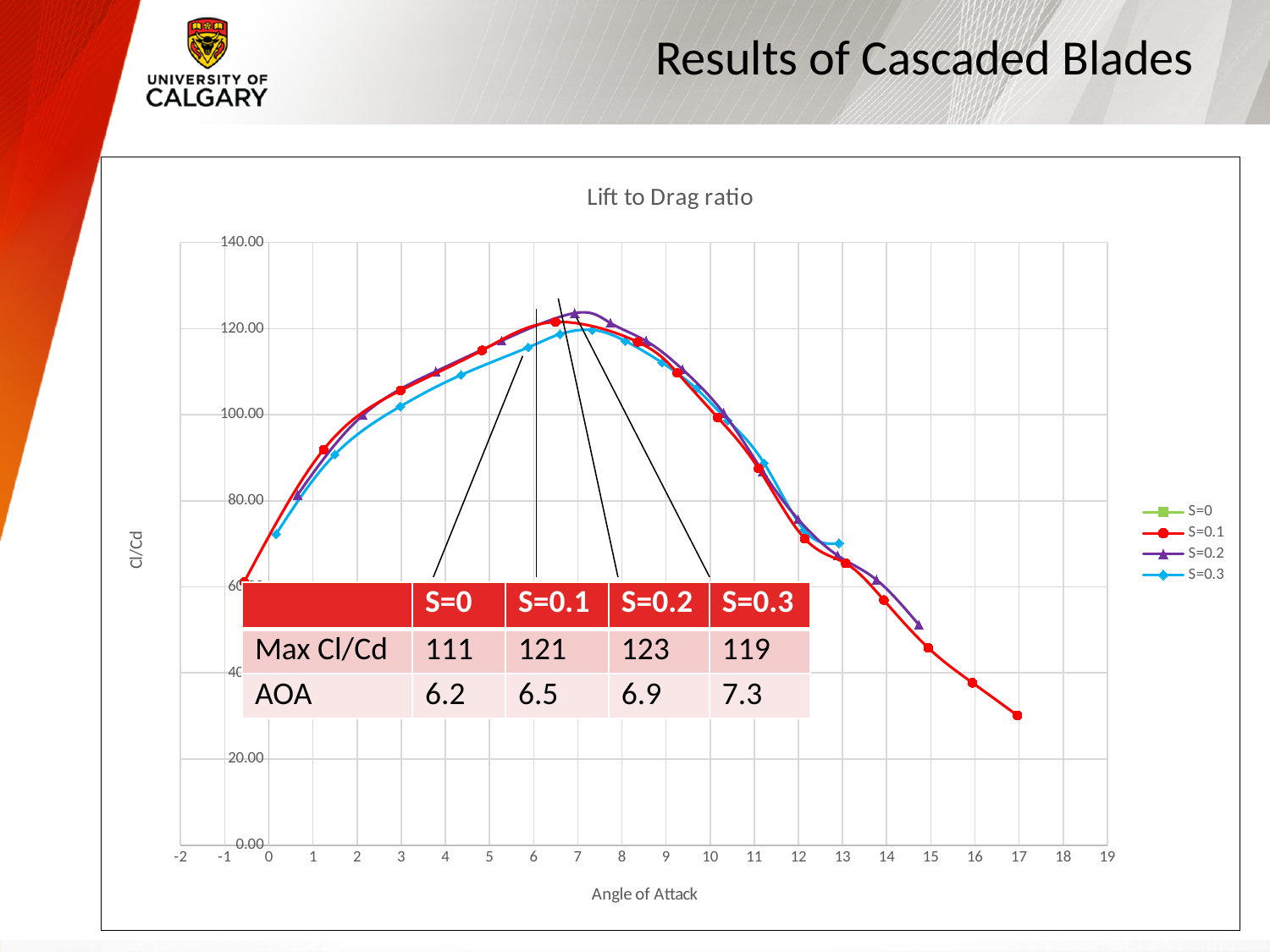
According to the table on the chart, what is the Max Cl/Cd for S=0.2? 123 What is the title of the chart? Lift to Drag ratio What is the difference between the Max Cl/Cd of S=0.2 and S=0 in the table on the chart? 12 Is the Cl/Cd value of the S=0.1 series at an angle of attack of 17 greater or less than 40.00? less What kind of chart is shown on the slide? line chart What is the label of the x axis of the chart? Angle of Attack Which has a larger Max Cl/Cd in the table on the chart, S=0.1 or S=0.3? S=0.1 Between an angle of attack of 10 and 17, does the S=0.1 series rise or fall? fall Which series has the lowest Max Cl/Cd in the table on the chart? S=0 How many series does the legend of the Lift to Drag ratio chart list? 4 According to the table on the chart, at what AOA does S=0.3 reach its Max Cl/Cd? 7.3 Which series has the highest Max Cl/Cd in the table on the chart? S=0.2